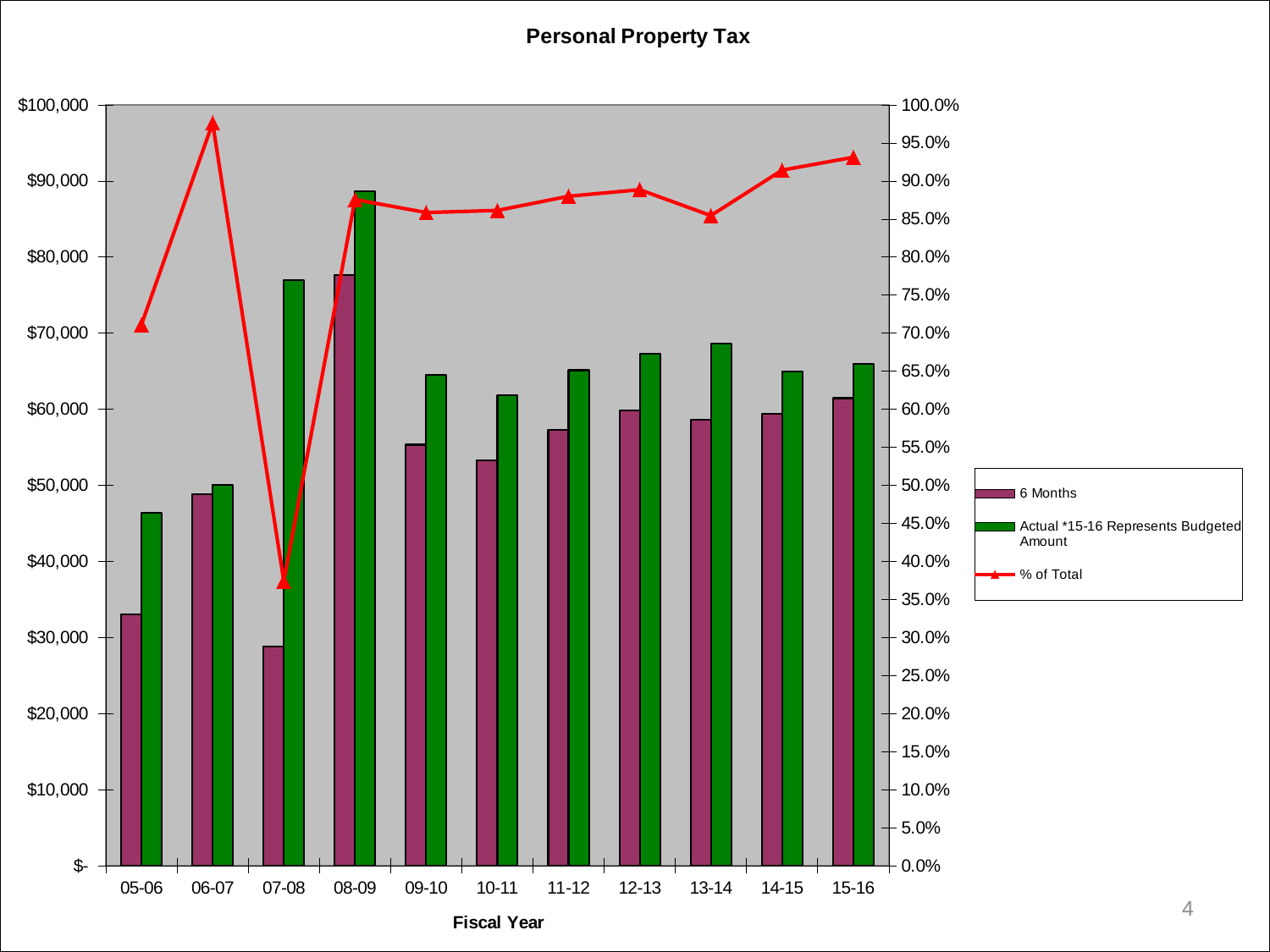
Is the 6 Months value for 08-09 greater or less than $70,000? greater Which fiscal year has the lowest % of Total? 07-08 What kind of chart is shown on the slide? A bar chart combined with a line How many fiscal years are shown on the x axis? 11 Which fiscal year has the highest % of Total? 06-07 Which fiscal year has the highest Actual value? 08-09 Which is larger, the 6 Months value for 05-06 or for 07-08? 05-06 What is the title of the x axis? Fiscal Year How many series does the legend list? 3 Is the Actual value for 07-08 greater or less than $80,000? less Is the % of Total for 15-16 greater or less than 90.0%? greater Which fiscal year has the lowest 6 Months value? 07-08